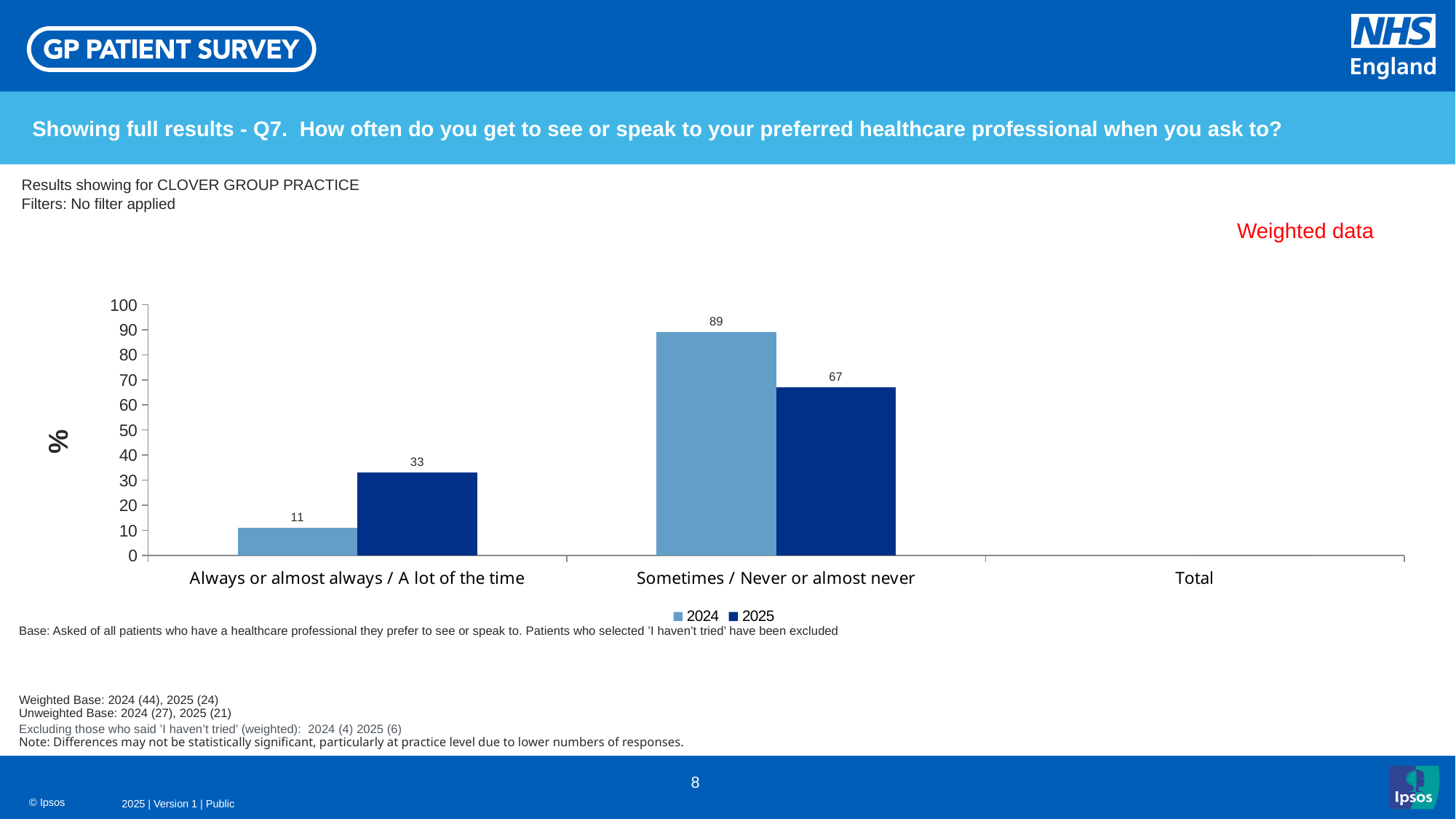
What is the difference between the 2025 and 2024 values for "Always or almost always / A lot of the time"? 22 For "Always or almost always / A lot of the time", which year has the larger value, 2024 or 2025? 2025 What is the 2025 value for "Always or almost always / A lot of the time"? 33 What is the 2024 value for "Sometimes / Never or almost never"? 89 What kind of chart is shown on the slide? Bar chart What label is shown on the vertical axis of the chart? % What is the difference between the 2024 and 2025 values for "Sometimes / Never or almost never"? 22 Which bar in the chart has the lowest value? 2024, Always or almost always / A lot of the time What is the 2024 value for "Always or almost always / A lot of the time"? 11 Which bar in the chart has the highest value? 2024, Sometimes / Never or almost never How many series does the legend list? 2 What is the 2025 value for "Sometimes / Never or almost never"? 67